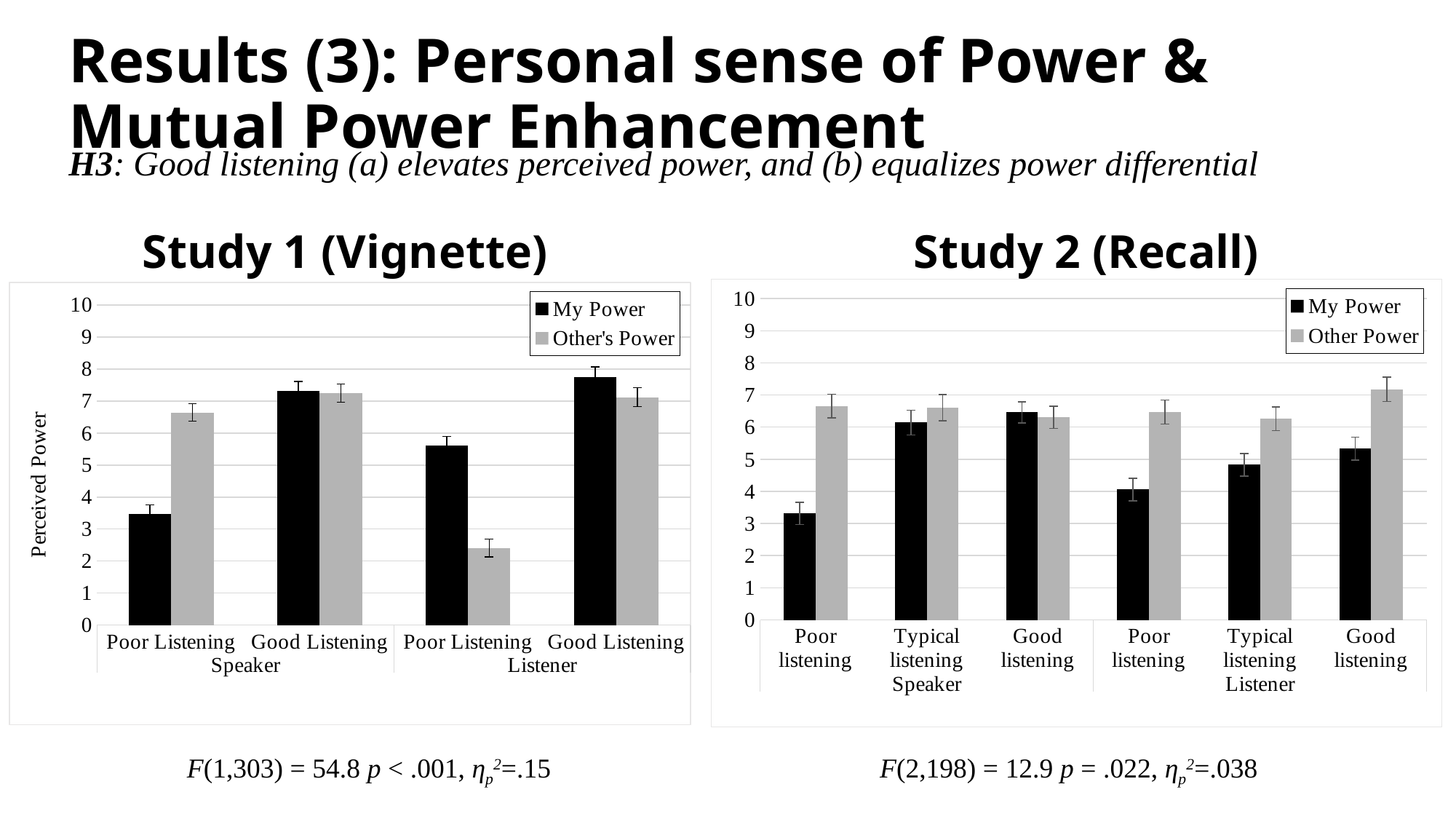
In the Study 1 (Vignette) chart, is the My Power value for Poor Listening (Speaker) greater or less than 4? less In the Study 2 (Recall) chart, which category has the highest Other Power value? Good listening (Listener) In the Study 2 (Recall) chart, which category has the lowest My Power value? Poor listening (Speaker) In the Study 1 (Vignette) chart, for Poor Listening (Speaker), which is larger: My Power or Other's Power? Other's Power In the Study 1 (Vignette) chart, how many series does the legend list? 2 In the Study 2 (Recall) chart, for Poor listening (Listener), which is larger: My Power or Other Power? Other Power In the Study 2 (Recall) chart, is the My Power value for Poor listening (Speaker) greater or less than 4? less In the Study 1 (Vignette) chart, is the Other's Power value for Poor Listening (Listener) greater or less than 3? less In the Study 1 (Vignette) chart, what kind of chart is shown? Bar chart In the Study 1 (Vignette) chart, which category has the highest My Power value? Good Listening (Listener) In the Study 2 (Recall) chart, how many categories are shown on the x axis? 6 In the Study 1 (Vignette) chart, which bar is the lowest overall? Other's Power for Poor Listening (Listener)